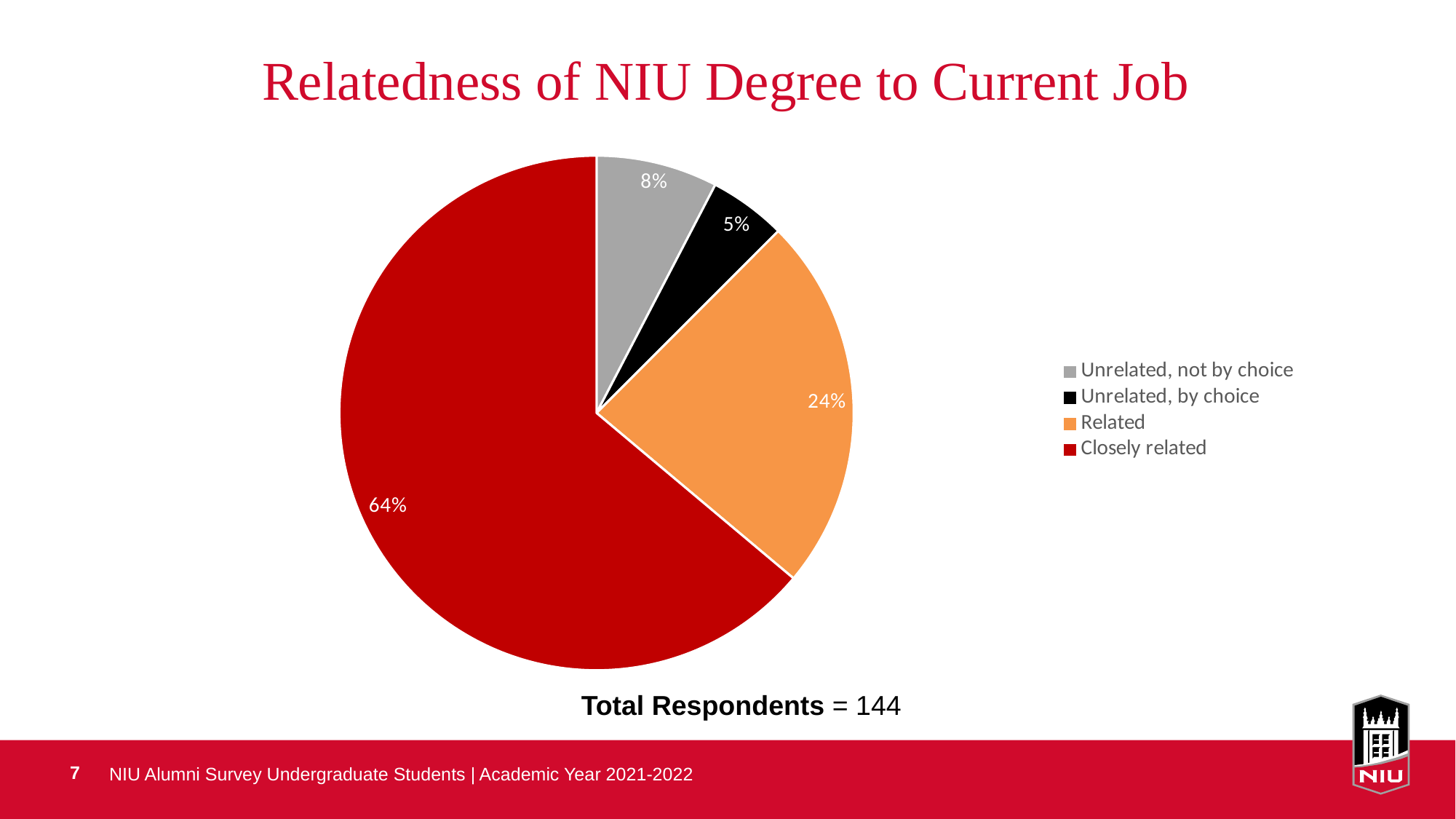
How many total respondents are reported below the chart? 144 How many categories does the pie chart show? 4 What percentage of respondents chose 'Unrelated, not by choice'? 8% Which category has the largest slice of the pie? Closely related Which is larger: the share for 'Unrelated, not by choice' or 'Unrelated, by choice'? Unrelated, not by choice What percentage of respondents chose 'Related'? 24% What is the difference in percentage points between 'Closely related' and 'Related'? 40 What percentage of respondents chose 'Unrelated, by choice'? 5% What share of respondents said their NIU degree is closely related to their current job? 64% What kind of chart is shown on the slide? pie chart Which category has the smallest slice of the pie? Unrelated, by choice What is the combined percentage of the two 'Unrelated' categories? 13%